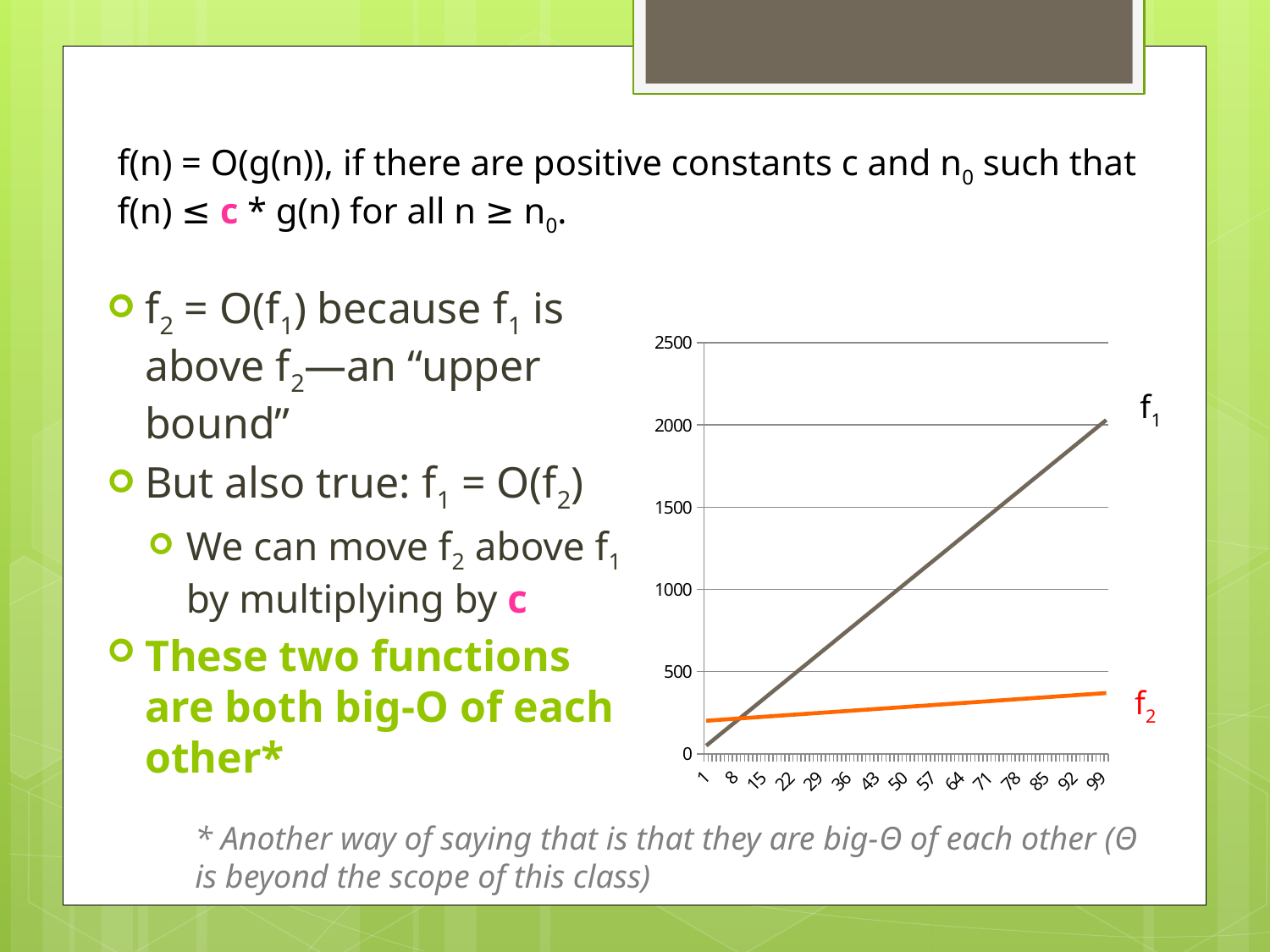
What kind of chart is shown on the slide? line chart Does the f2 line rise or fall as n increases along the x axis? rise How many labeled tick marks are there on the x axis of the chart? 15 At the right end of the chart (n = 99), which series has the larger value, f1 or f2? f1 Does the f1 line rise or fall as n increases along the x axis? rise How many series are plotted on the chart? 2 Is the value of f1 at n = 99 greater or less than 1500? greater Is the value of f2 at n = 99 greater or less than 500? less Is the value of f1 at n = 1 greater or less than 500? less What is the highest value labeled on the y axis of the chart? 2500 At the left end of the chart (n = 1), which series has the larger value, f1 or f2? f2 What are the names of the two series plotted on the chart? f1 and f2